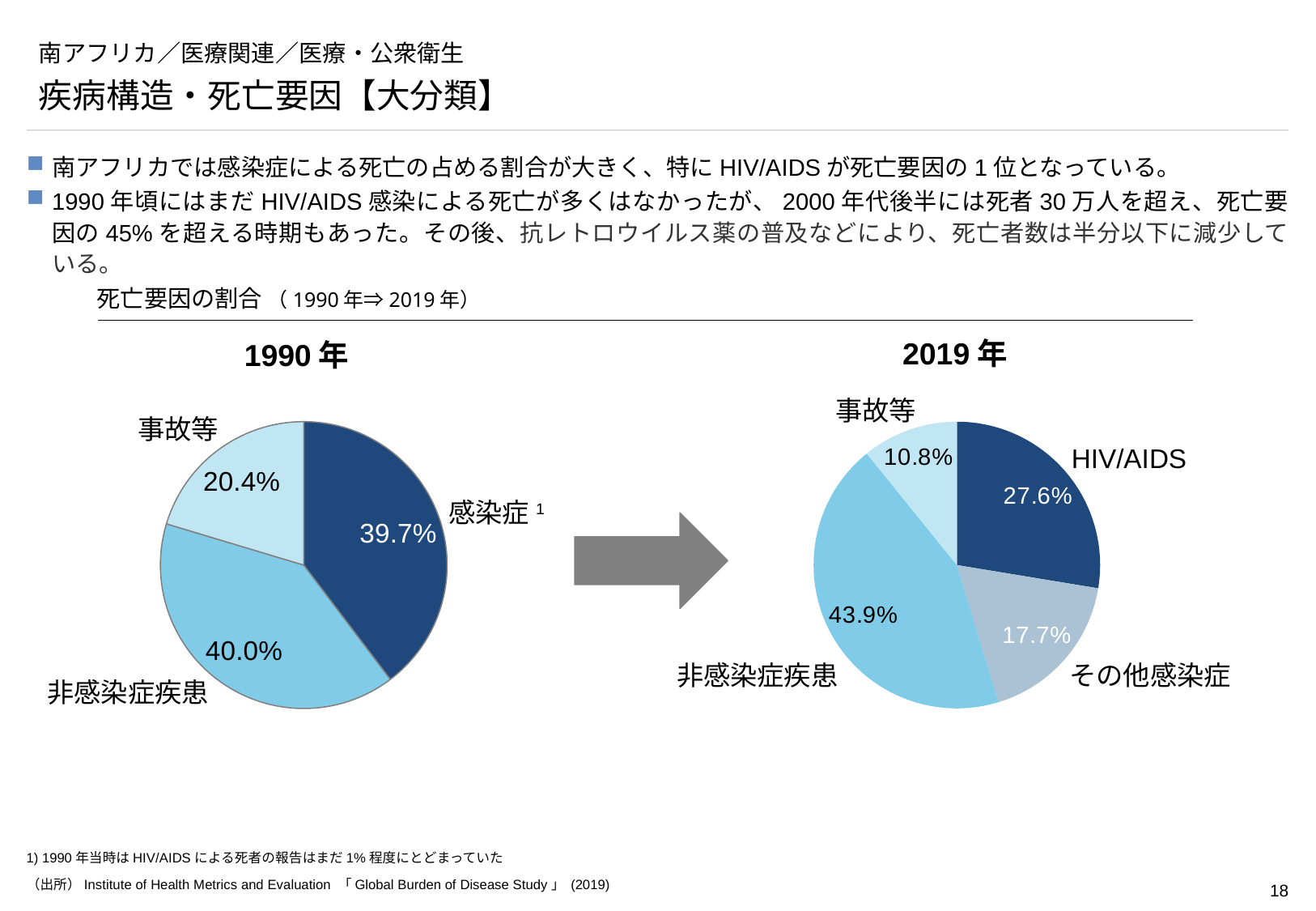
In the 2019年 pie chart, what share is shown for その他感染症? 17.7% In the 2019年 pie chart, which is larger, the share of HIV/AIDS or the share of その他感染症? HIV/AIDS In the 2019年 pie chart, which category has the smallest share? 事故等 How many slices does the 1990年 pie chart have? 3 In the 2019年 pie chart, which category has the largest share? 非感染症疾患 In the 1990年 pie chart, which category has the smallest share? 事故等 In the 2019年 pie chart, what is the difference between the shares of 非感染症疾患 and HIV/AIDS? 16.3% In the 2019年 pie chart, what share is shown for HIV/AIDS? 27.6% In the 1990年 pie chart, what share is shown for 事故等? 20.4% How many slices does the 2019年 pie chart have? 4 In the 1990年 pie chart, what share is shown for 感染症? 39.7% What type of chart is used for the 1990年 and 2019年 data? Pie chart